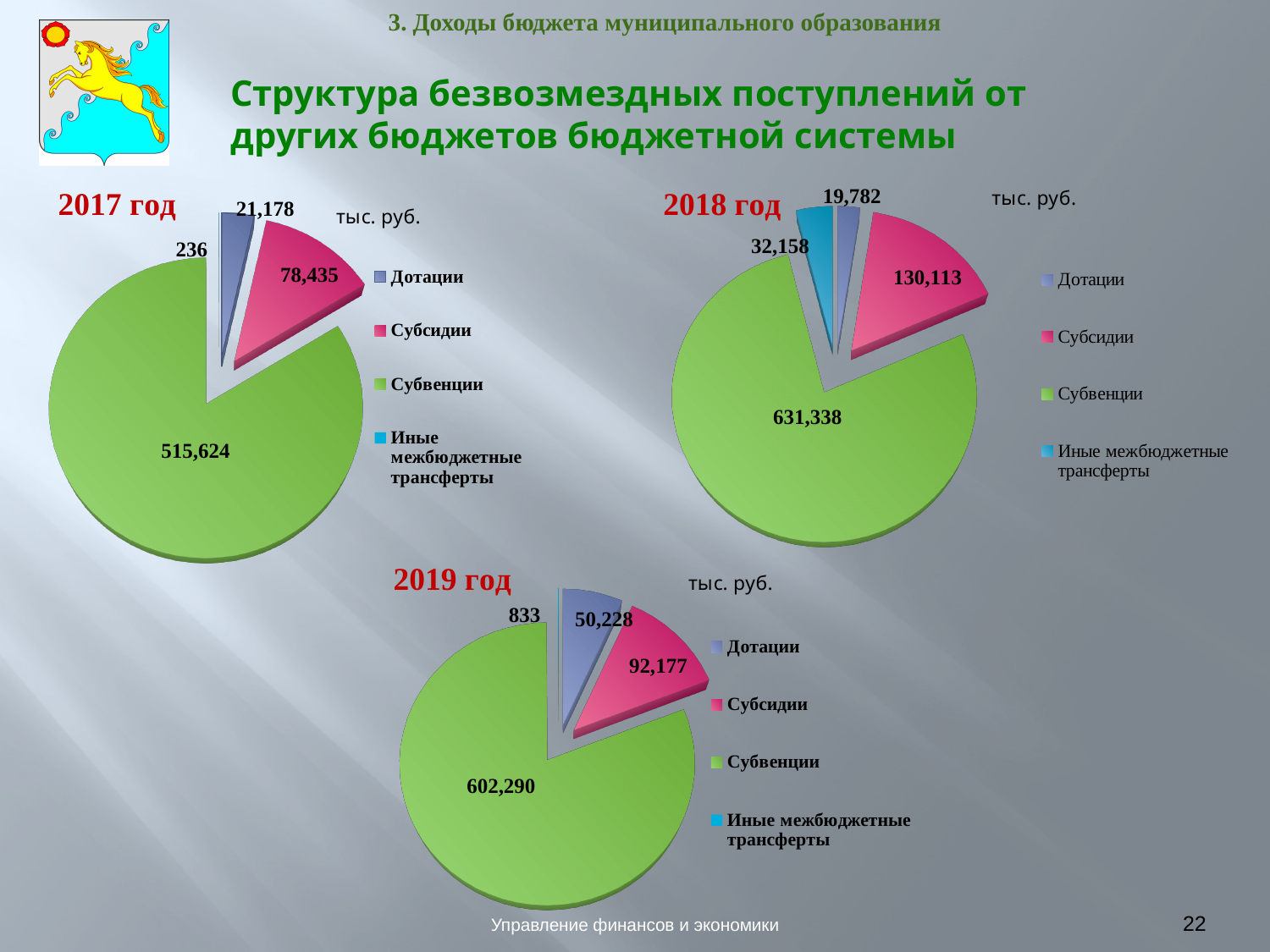
In the 2019 год chart, which category has the largest slice? Субвенции In the 2018 год chart, what is the value for Субвенции? 631,338 In the 2019 год chart, what is the value for Дотации? 50,228 What type of chart is used for the 2017 год data? pie chart In the 2018 год chart, which is larger: Субсидии or Иные межбюджетные трансферты? Субсидии What unit is stated next to each pie chart? тыс. руб. In the 2018 год chart, what is the value for Субсидии? 130,113 In the 2017 год chart, what is the value for Субвенции? 515,624 In the 2017 год chart, what is the value for Субсидии? 78,435 How many categories does the legend of the 2018 год chart list? 4 In the 2019 год chart, what is the difference between Субвенции and Субсидии? 510,113 In the 2019 год chart, which category has the smallest slice? Иные межбюджетные трансферты